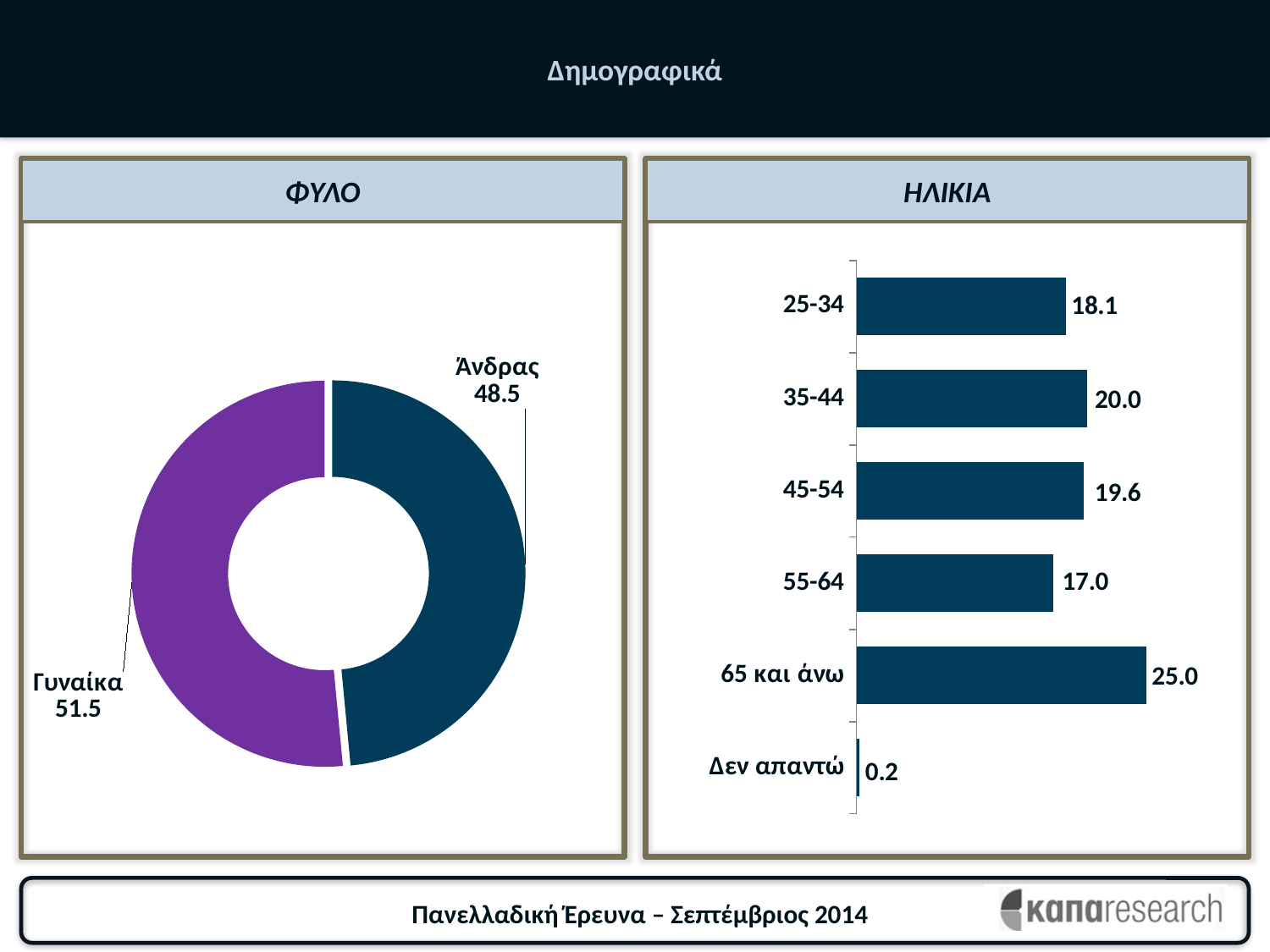
What kind of chart is the ΗΛΙΚΙΑ chart? Bar chart In the ΦΥΛΟ chart, what is the value for Γυναίκα? 51.5 What kind of chart is the ΦΥΛΟ chart? Doughnut chart In the ΦΥΛΟ chart, what is the value for Άνδρας? 48.5 In the ΗΛΙΚΙΑ chart, which category has the highest value? 65 και άνω In the ΗΛΙΚΙΑ chart, which category has the lowest value? Δεν απαντώ In the ΗΛΙΚΙΑ chart, what is the value for 35-44? 20.0 In the ΦΥΛΟ chart, which category has the larger value, Άνδρας or Γυναίκα? Γυναίκα In the ΦΥΛΟ chart, what is the difference between the Γυναίκα and Άνδρας values? 3.0 How many categories are shown in the ΗΛΙΚΙΑ chart? 6 In the ΗΛΙΚΙΑ chart, what is the value for 65 και άνω? 25.0 In the ΗΛΙΚΙΑ chart, what is the difference between the values for 65 και άνω and 55-64? 8.0